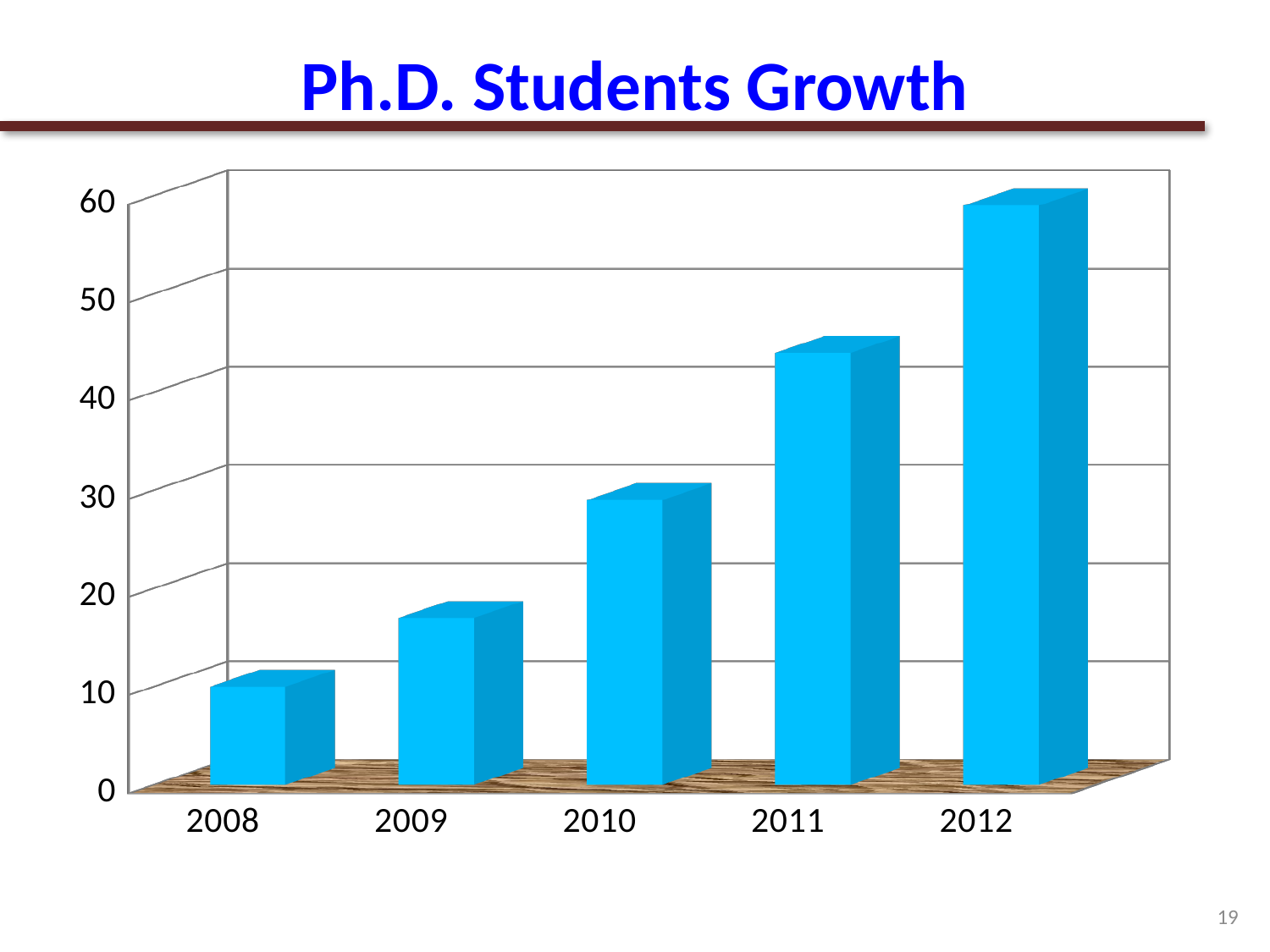
Is the value for 2009 greater or less than 30? less Do the values rise or fall from 2008 to 2012? rise Is the value for 2012 greater or less than 50? greater Is the value for 2011 greater or less than 40? greater Which year has the highest bar? 2012 Which is larger, the value for 2010 or the value for 2011? 2011 What is the title of the chart? Ph.D. Students Growth What type of chart is shown on the slide? bar chart Which year has the lowest bar? 2008 How many years are shown on the x axis of the chart? 5